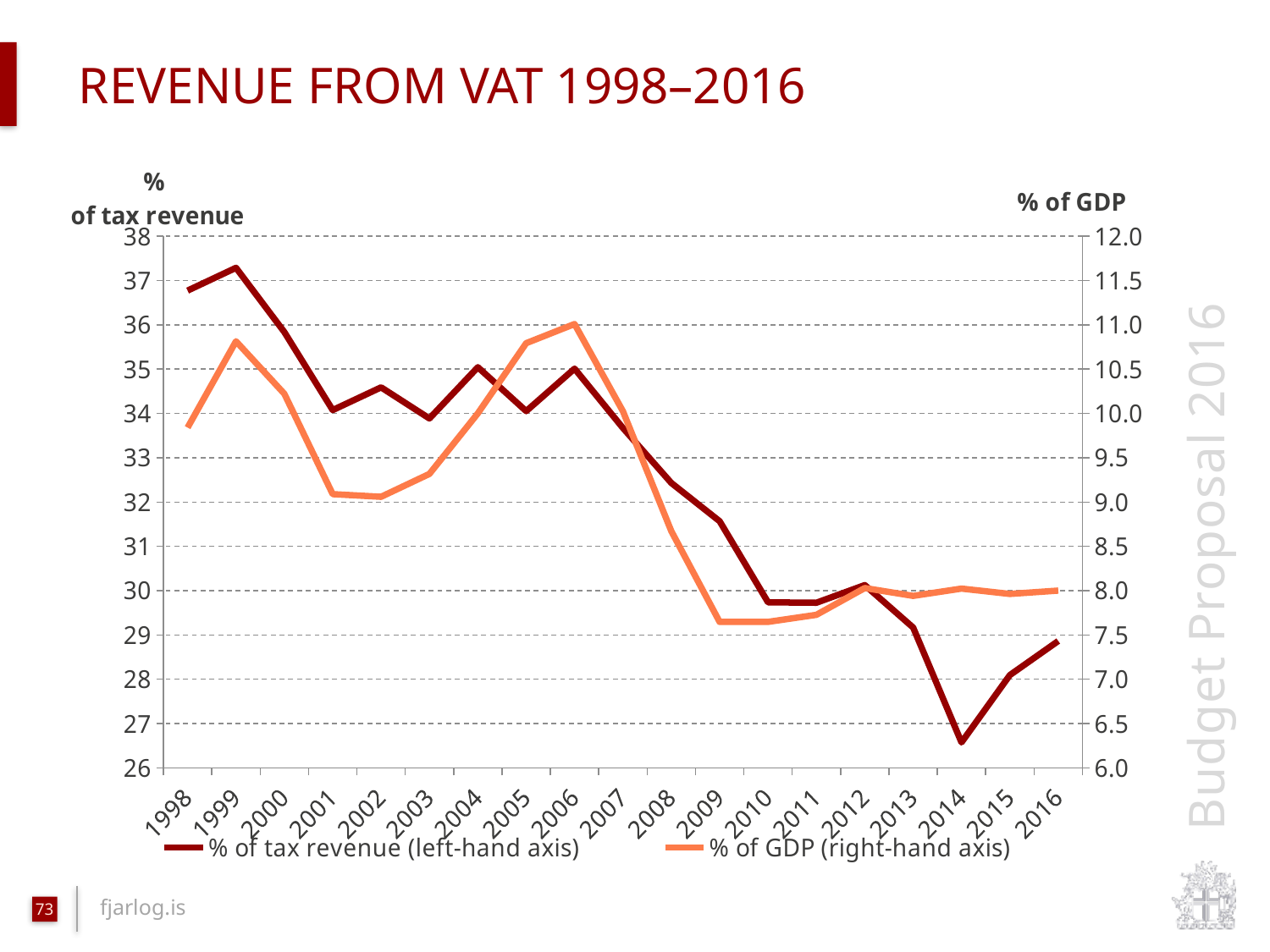
Is the value for % of GDP in 2001 greater or less than 9.5? less Which series is plotted against the right-hand axis? % of GDP How many years are plotted along the x axis? 19 In which year is the % of tax revenue series at its lowest? 2014 What kind of chart is shown on the slide? line chart In which year does the % of GDP series reach its highest value? 2006 How many series does the legend list? 2 Is the value for % of GDP in 2006 greater or less than 10.5? greater Is the value for % of tax revenue in 1998 greater or less than 36? greater Does the % of tax revenue series rise or fall between 2006 and 2014? fall In which year is the % of tax revenue series at its highest? 1999